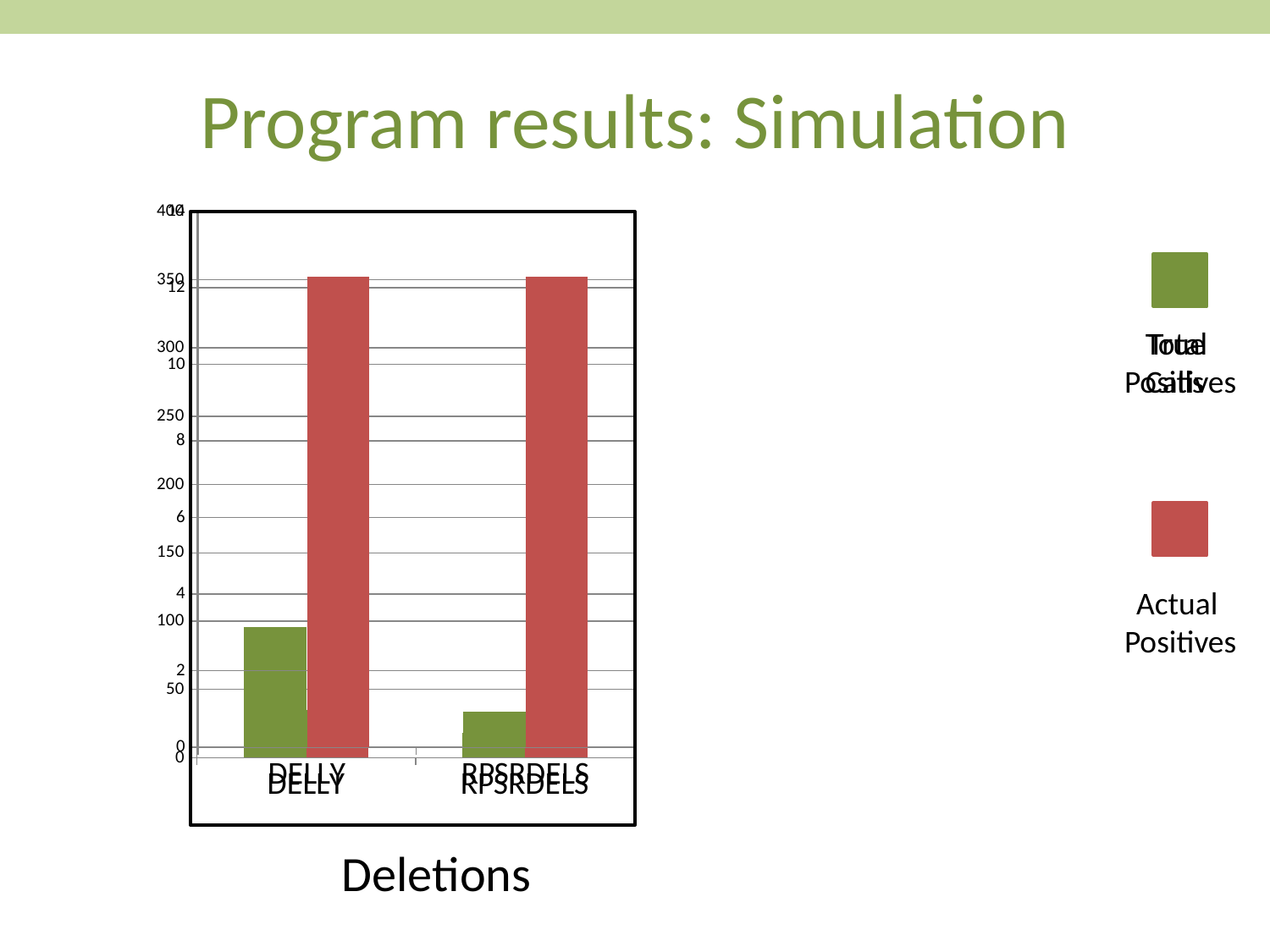
What is the x-axis title of the chart? Deletions Which category has the taller green bar, DELLY or RPSRDELS? DELLY What are the two categories on the x axis of the chart? DELLY and RPSRDELS What kind of chart is shown on the slide? bar chart Which category has the lowest green bar? RPSRDELS For DELLY, which bar is taller: the green bar or the red bar? the red bar For RPSRDELS, which bar is taller: the green bar or the red bar? the red bar How many bars are plotted for each category? 2 Do the green bars rise or fall from DELLY to RPSRDELS? fall How many categories are shown on the x axis of the chart? 2